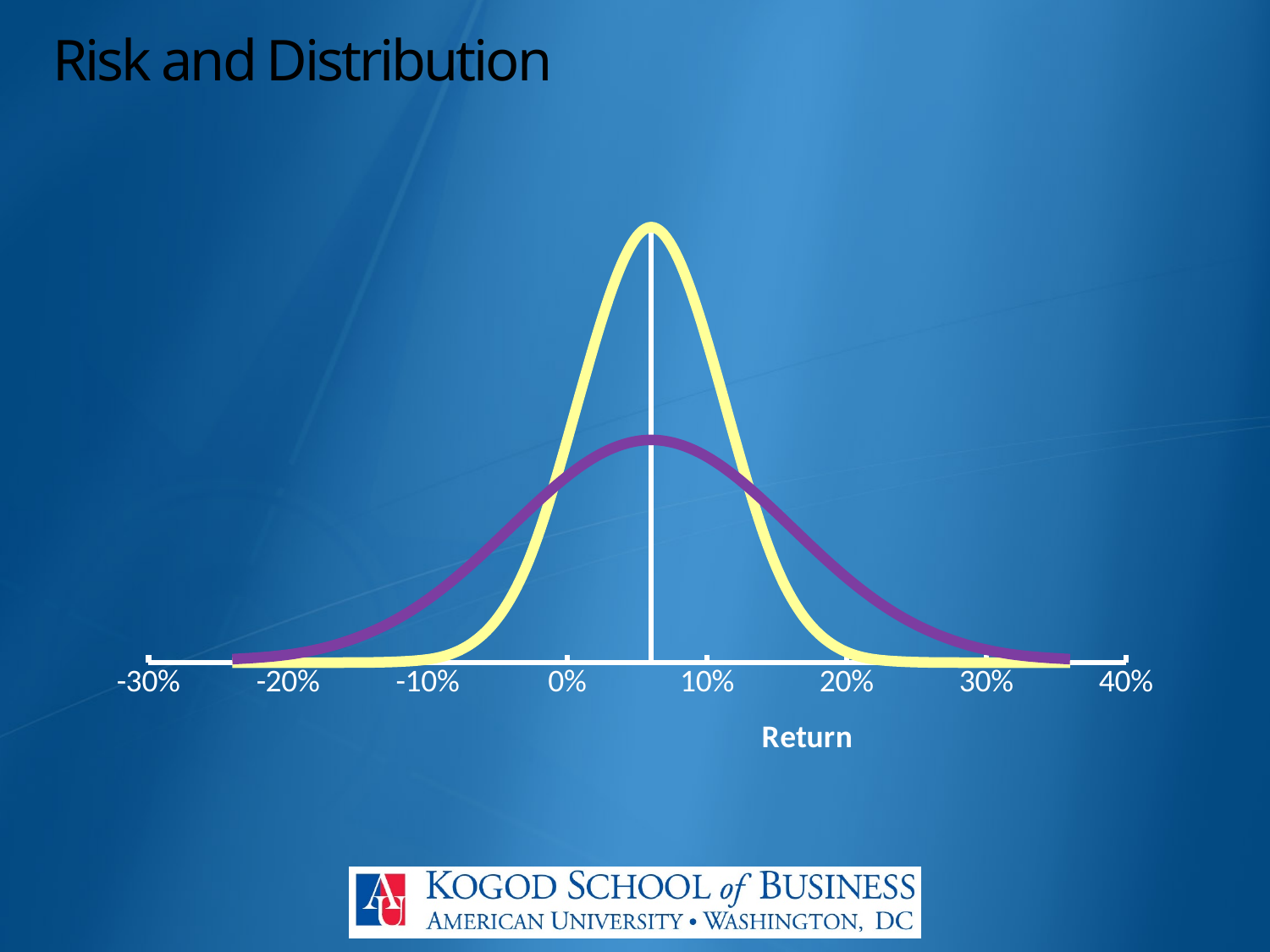
What is the lowest value labelled on the horizontal axis? -30% Which curve reaches the higher peak, the yellow one or the purple one? yellow Is the peak of the yellow curve located at a return greater or less than 0%? greater What is the title of the slide containing the chart? Risk and Distribution What kind of chart is shown on the slide? line chart Is the peak of the purple curve located at a return greater or less than 10%? less How many curves are plotted on the chart? 2 What is the highest value labelled on the horizontal axis? 40% Which curve is spread more widely along the Return axis, the yellow one or the purple one? purple How many tick labels are shown on the horizontal axis? 8 What is the title of the horizontal axis? Return